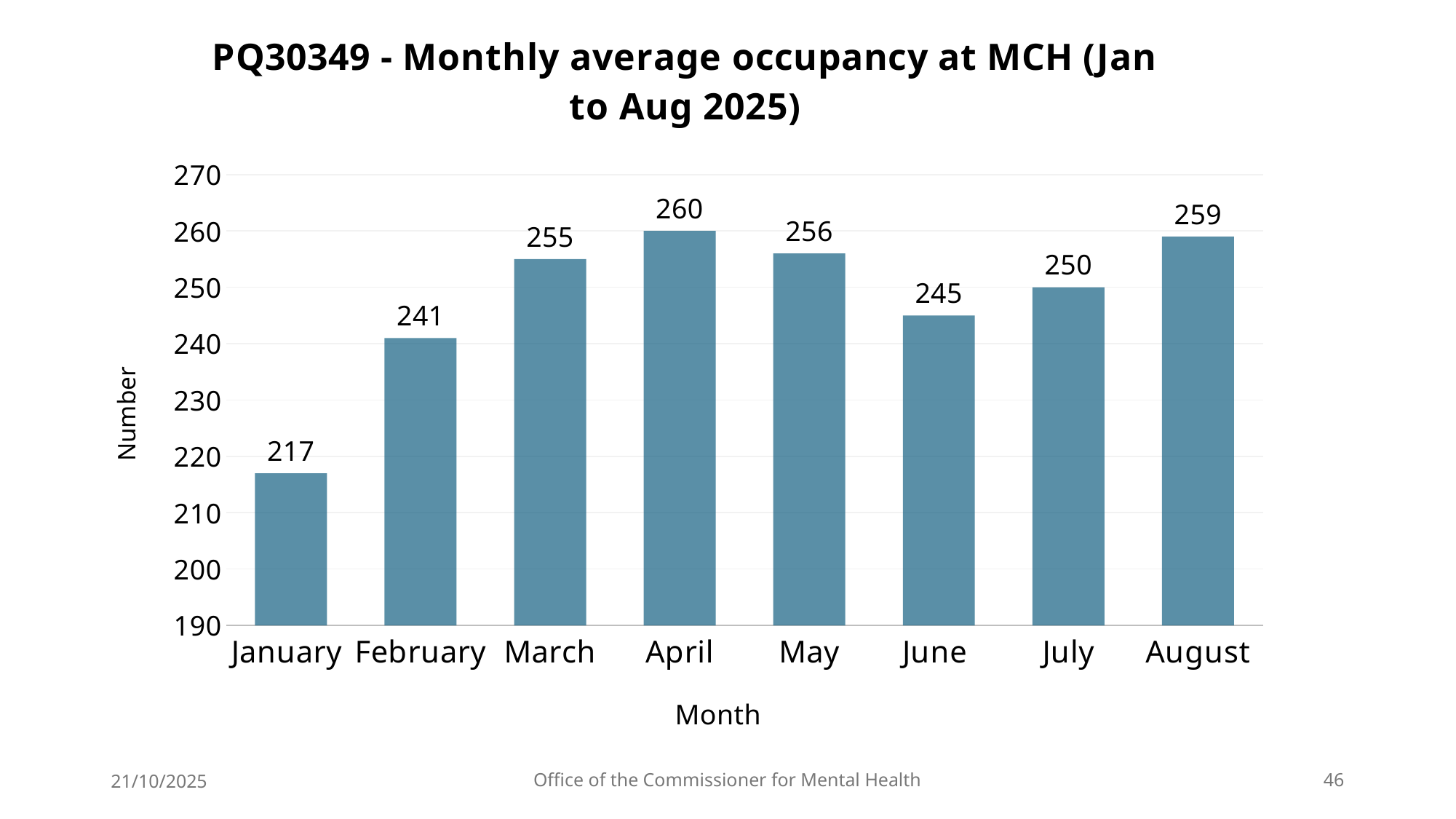
What is the difference between the May and June values? 11 Which month has the lowest monthly average occupancy? January How many months are shown on the chart? 8 What is the monthly average occupancy at MCH for August? 259 What is the label of the y axis? Number Is the value for February greater or less than 250? less What kind of chart is shown on the slide? bar chart What is the difference between the April and January values? 43 Which is larger, the value for March or the value for July? March What is the monthly average occupancy at MCH for June? 245 What is the monthly average occupancy at MCH for January? 217 Which month has the highest monthly average occupancy? April